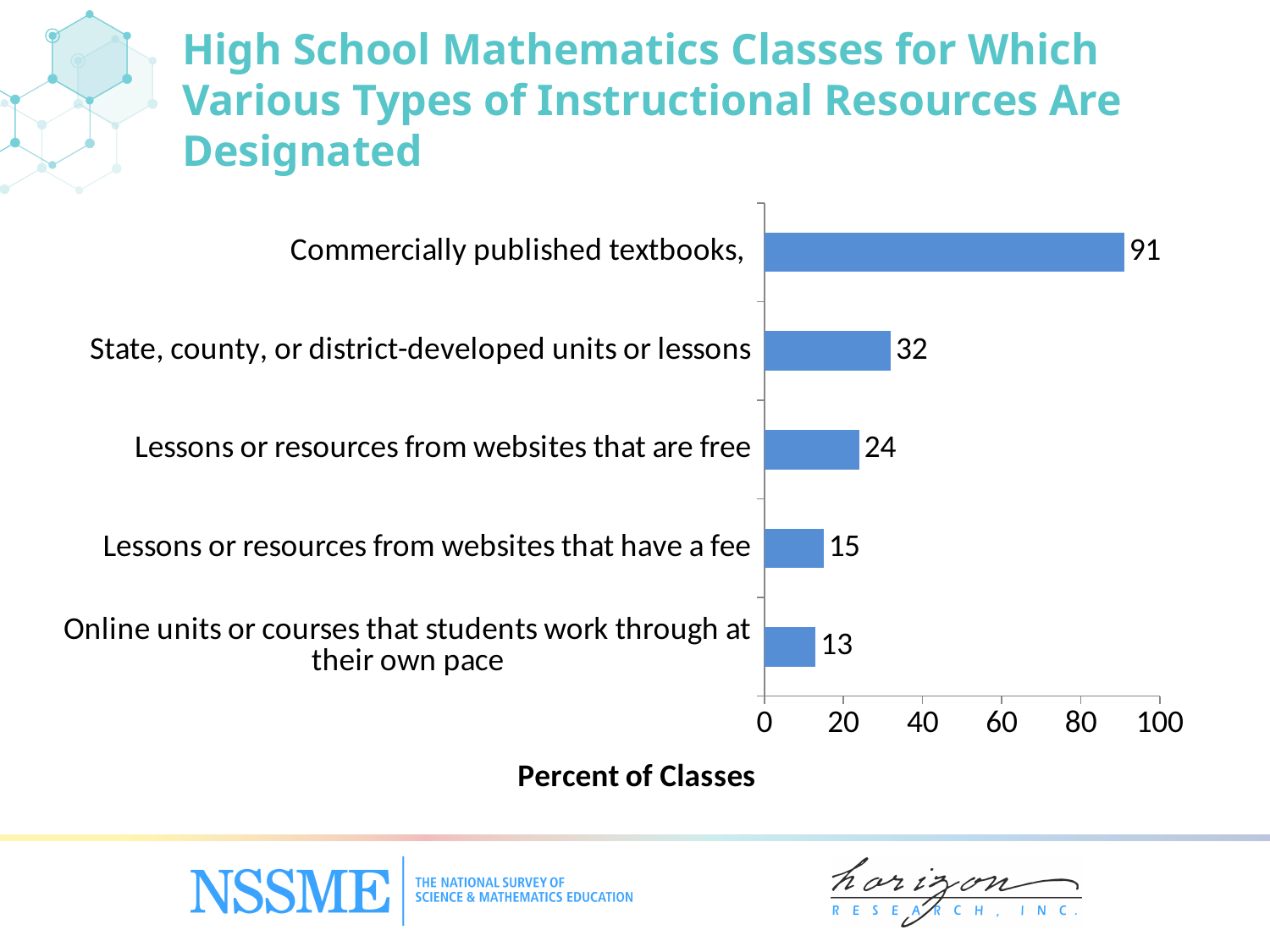
What is the label of the horizontal axis? Percent of Classes How many categories are shown in the chart? 5 What is the value for State, county, or district-developed units or lessons? 32 What kind of chart is shown on the slide? Bar chart What is the value for Lessons or resources from websites that are free? 24 What is the value for Online units or courses that students work through at their own pace? 13 What is the value for Commercially published textbooks? 91 Which category has the highest value? Commercially published textbooks What is the value for Lessons or resources from websites that have a fee? 15 Which category has the lowest value? Online units or courses that students work through at their own pace Which is larger: the value for Lessons or resources from websites that are free or the value for Lessons or resources from websites that have a fee? Lessons or resources from websites that are free What is the difference between the values for Commercially published textbooks and State, county, or district-developed units or lessons? 59